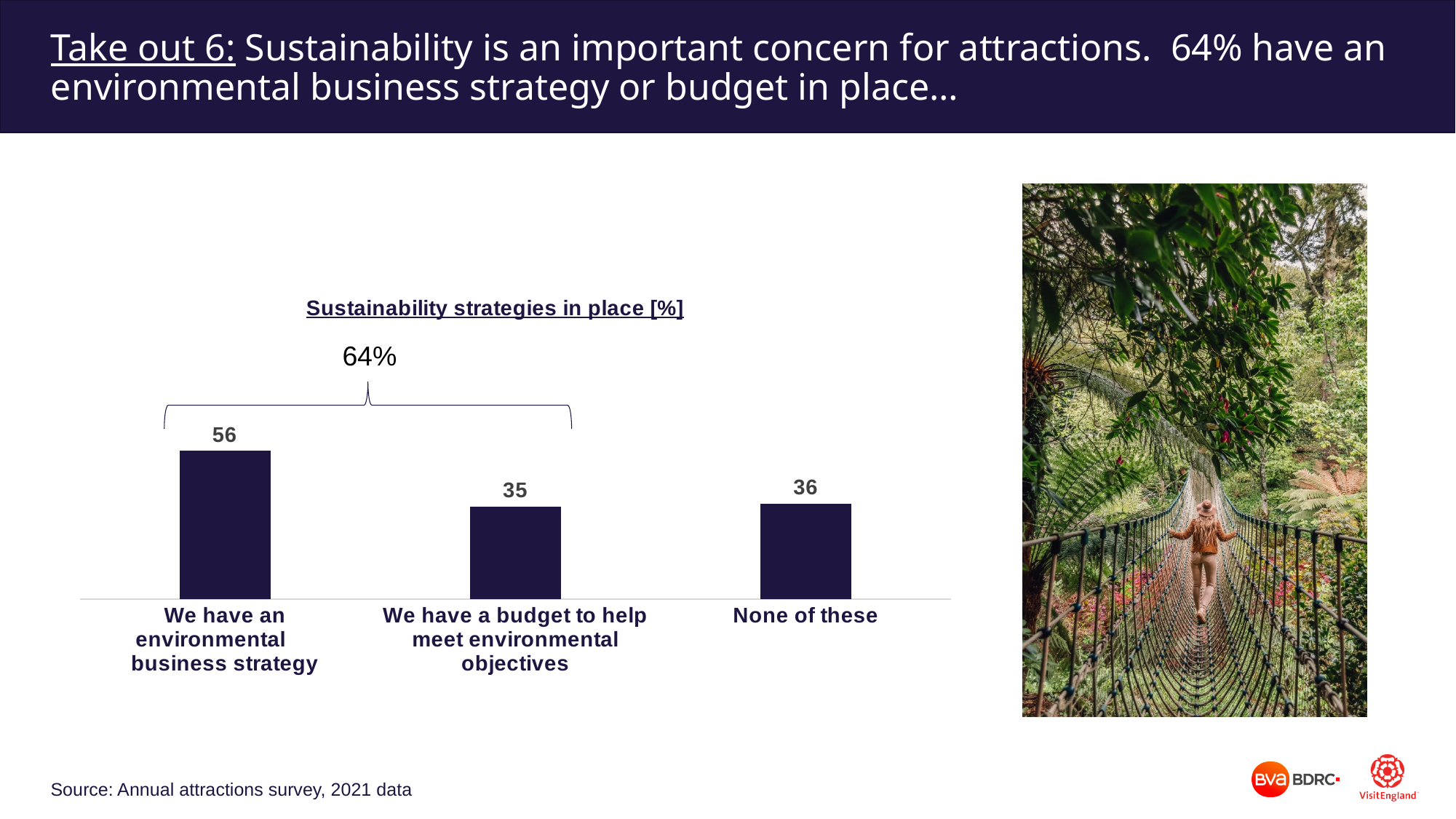
What is the title of the chart? Sustainability strategies in place [%] What is the value for "We have an environmental business strategy"? 56 How many categories are shown in the chart? 3 Which category has the lowest value? We have a budget to help meet environmental objectives What is the difference between the value for "None of these" and the value for "We have a budget to help meet environmental objectives"? 1 Which is larger: the value for "We have an environmental business strategy" or the value for "None of these"? We have an environmental business strategy Which category has the highest value? We have an environmental business strategy What is the difference between the value for "We have an environmental business strategy" and the value for "None of these"? 20 What is the value for "None of these"? 36 What is the value for "We have a budget to help meet environmental objectives"? 35 What percentage is shown by the bracket spanning the first two bars? 64% What kind of chart is shown on the slide? Bar chart